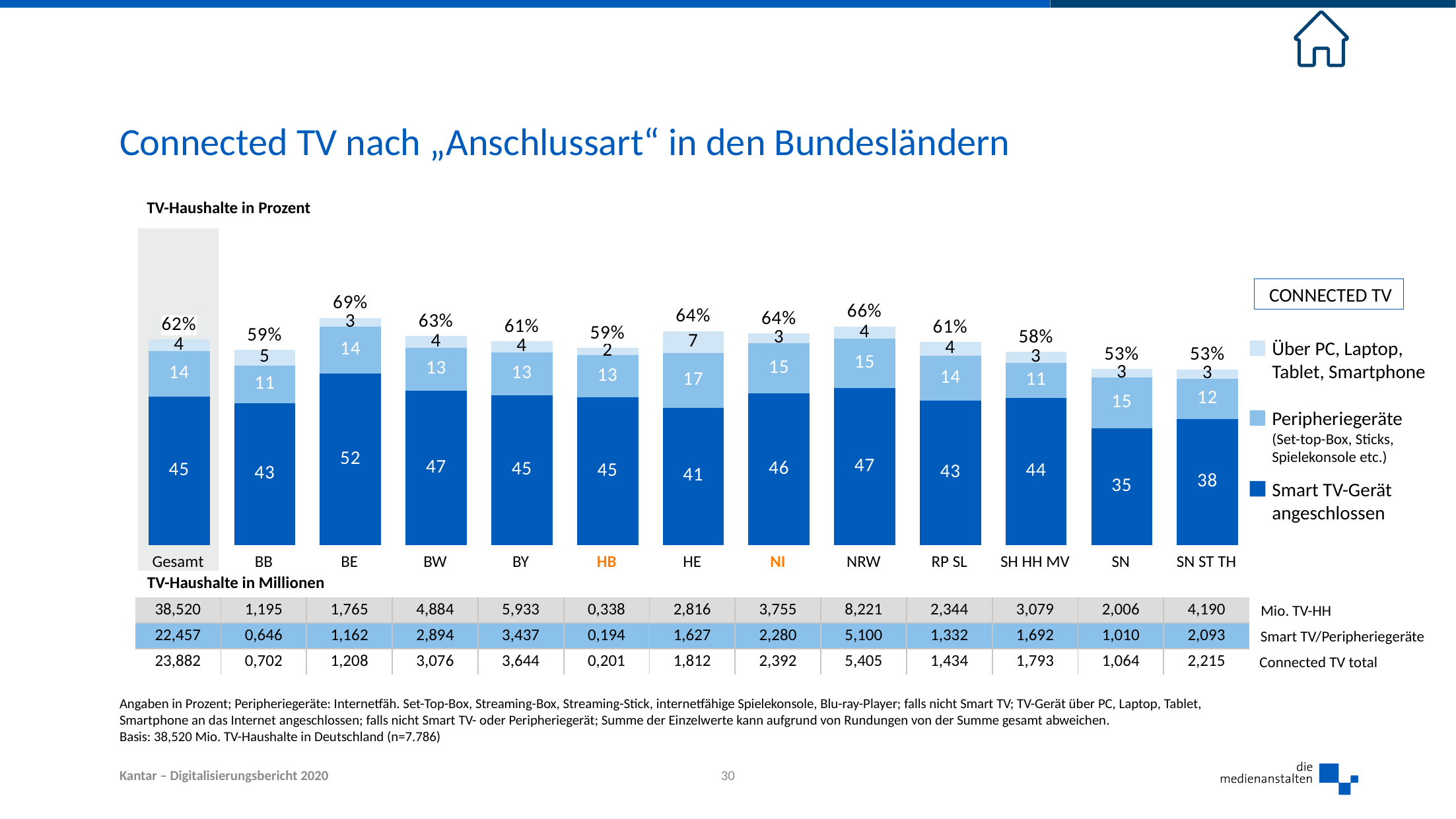
How many series does the legend list? 3 What is the total of the stacked bar for NRW? 66% What is the difference between the Connected TV total for BE and for Gesamt? 7 percentage points Which category has the lowest value for "Smart TV-Gerät angeschlossen"? SN Which has the larger value for "Peripheriegeräte": HE or BB? HE What is the value for "Smart TV-Gerät angeschlossen" for BE? 52 What is the value for "Über PC, Laptop, Tablet, Smartphone" for HE? 7 What kind of chart is shown on the slide? Stacked bar chart How many categories are shown on the x axis of the chart? 13 Which category has the highest Connected TV total percentage? BE What is the value for "Peripheriegeräte" for HE? 17 What is the Connected TV total percentage shown above the bar for Gesamt? 62%